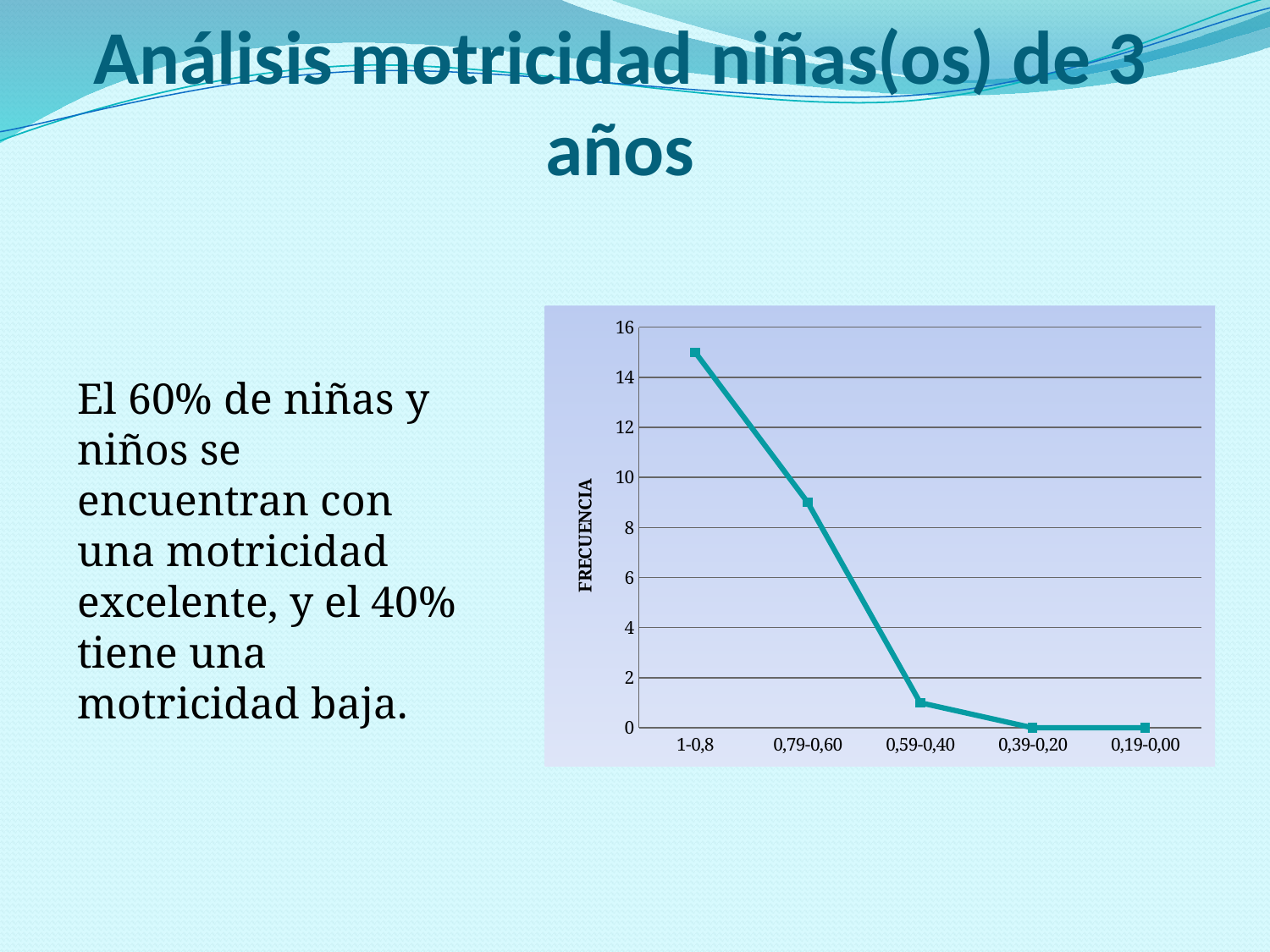
What kind of chart is shown on the slide? line chart Which is larger, the value for 1-0,8 or the value for 0,79-0,60? 1-0,8 What is the value for the category 0,39-0,20? 0 What is the value for the category 0,19-0,00? 0 Is the value for 1-0,8 greater or less than 14? greater How many categories are plotted along the x axis? 5 Do the values rise or fall moving from left to right along the x axis? fall Which is larger, the value for 0,79-0,60 or the value for 0,59-0,40? 0,79-0,60 What is the label on the vertical axis of the chart? FRECUENCIA Which category has the highest frequency? 1-0,8 Is the value for 0,59-0,40 greater or less than 2? less Is the value for 0,79-0,60 greater or less than 10? less